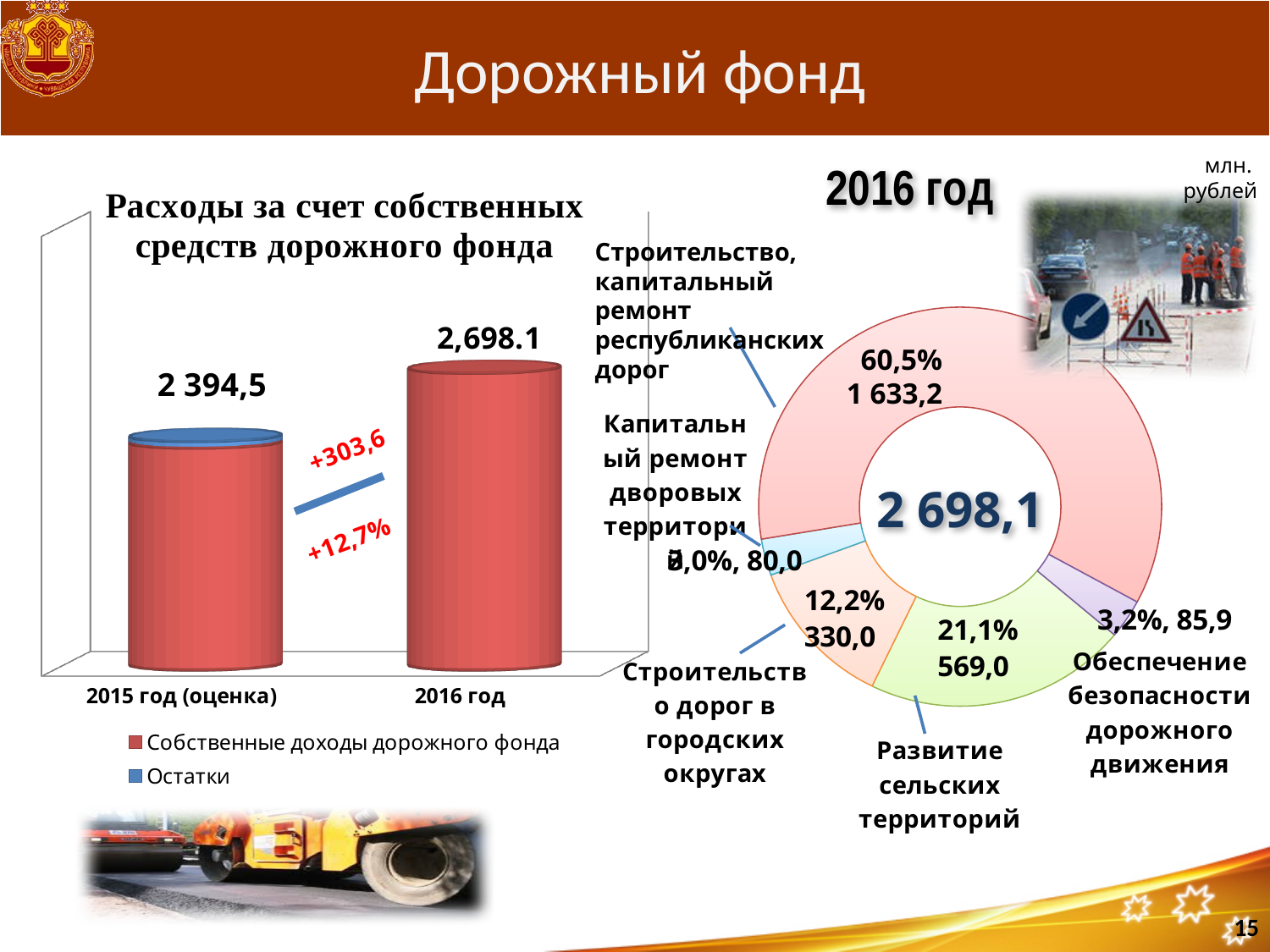
In the doughnut chart '2016 год', what is the difference between the values for 'Развитие сельских территорий' and 'Строительство дорог в городских округах'? 239,0 How many series does the legend of the bar chart on the left list? 2 In the doughnut chart '2016 год', which category has the largest slice? Строительство, капитальный ремонт республиканских дорог In the bar chart 'Расходы за счет собственных средств дорожного фонда', what is the value shown for 2015 год (оценка)? 2 394,5 How many slices does the doughnut chart '2016 год' have? 5 What total is shown in the centre of the doughnut chart '2016 год'? 2 698,1 What kind of chart is the chart on the left of the slide? bar chart In the bar chart on the left, which year has the higher value, 2015 год (оценка) or 2016 год? 2016 год In the bar chart on the left, what absolute increase is annotated between the 2015 and 2016 bars? +303,6 In the doughnut chart '2016 год', what is the value for 'Строительство дорог в городских округах'? 330,0 In the doughnut chart '2016 год', what share does 'Развитие сельских территорий' have? 21,1% In the bar chart 'Расходы за счет собственных средств дорожного фонда', what is the value shown for 2016 год? 2,698.1